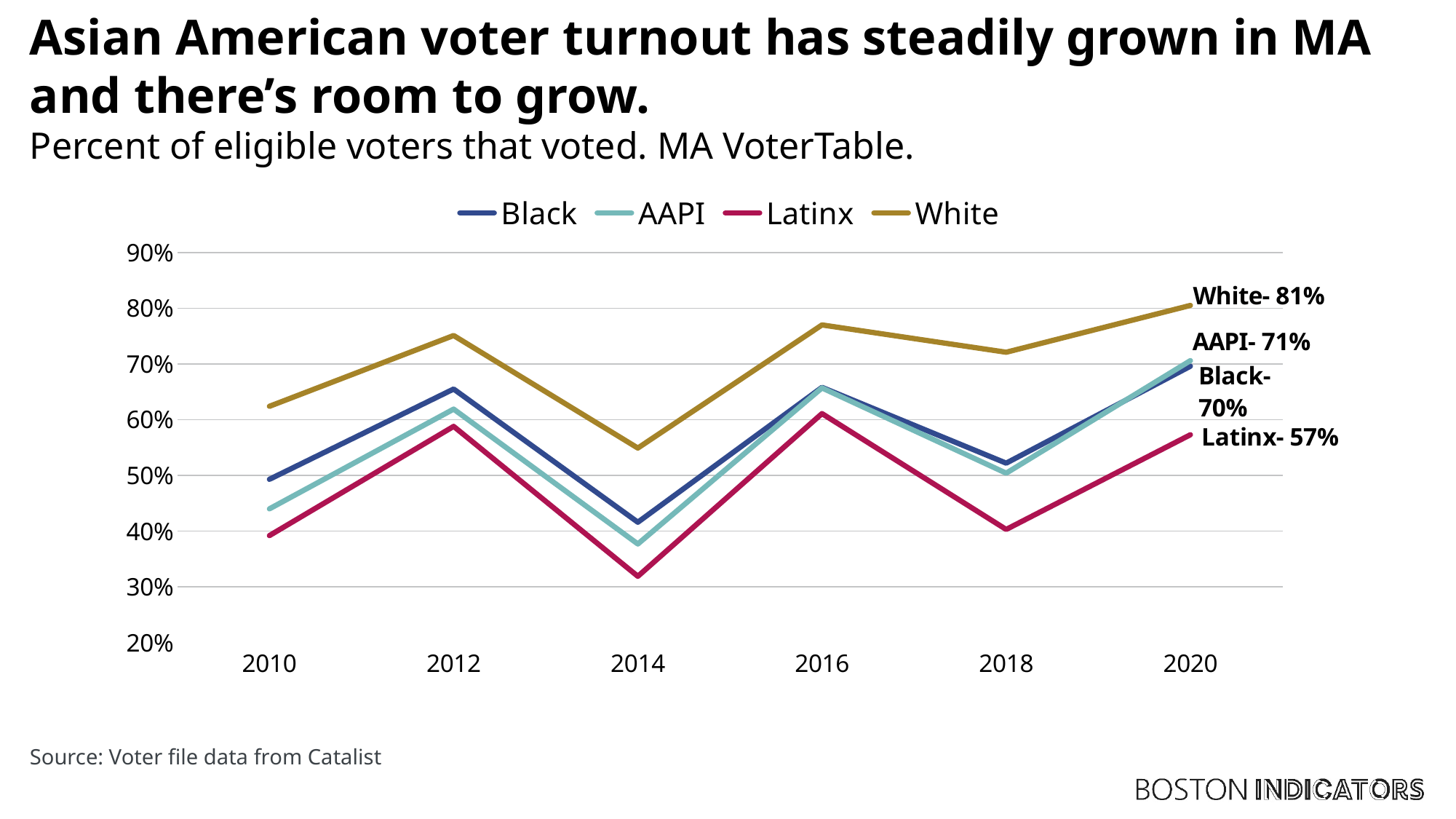
What is the AAPI voter turnout in 2020? 71% What is the White voter turnout in 2020? 81% Which group had the highest turnout in 2020? White What kind of chart is shown on the slide? Line chart Which group had the lowest turnout in 2020? Latinx What is the difference between White and Latinx turnout in 2020? 24% How many years are shown on the x axis? 6 How many series does the legend list? 4 Is the Latinx turnout in 2014 greater or less than 40%? less What is the Latinx voter turnout in 2020? 57% Which is larger in 2020, AAPI turnout or Latinx turnout? AAPI What is the Black voter turnout in 2020? 70%